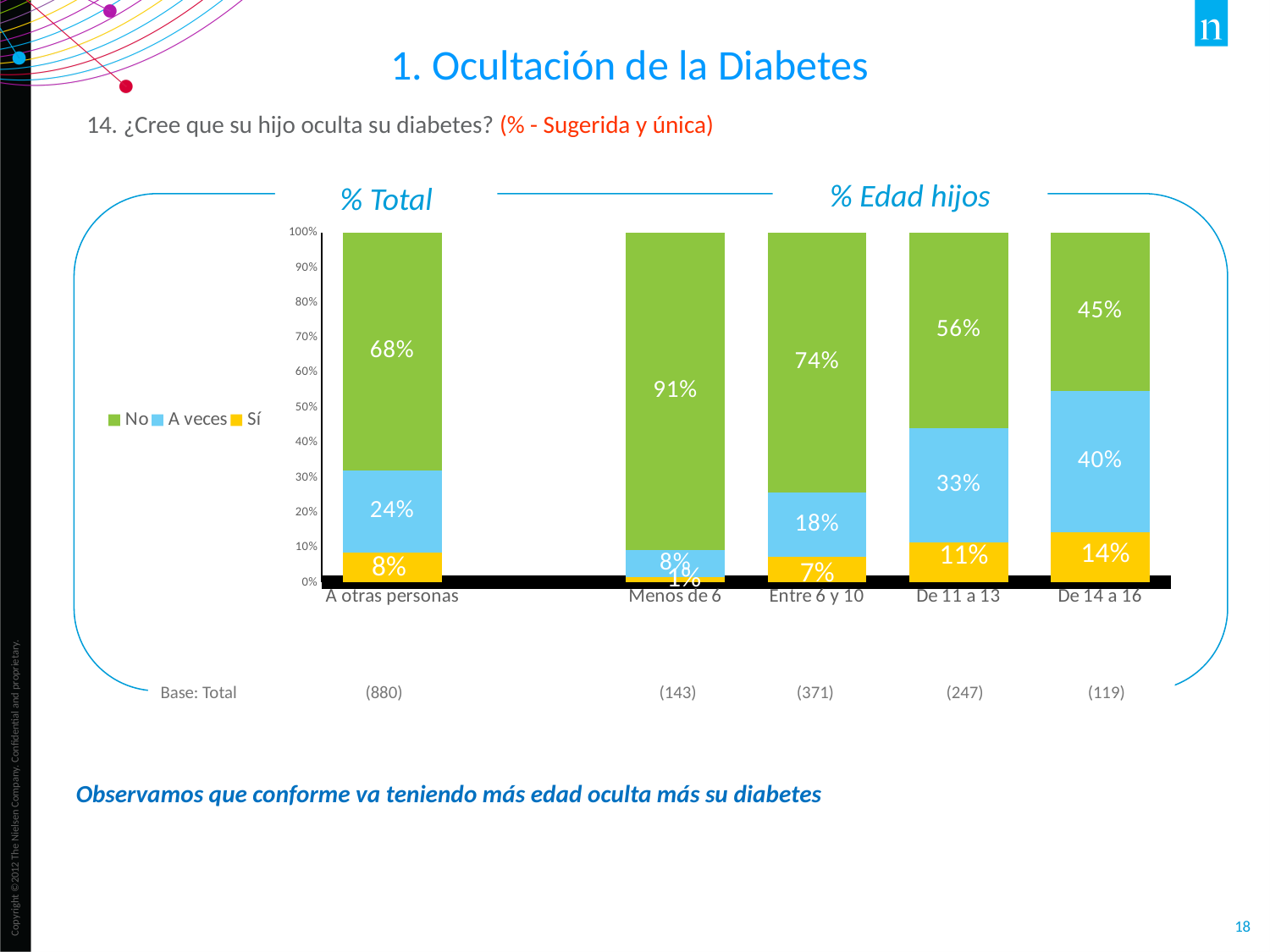
Across the age groups from "Menos de 6" to "De 14 a 16", does the "Sí" value rise or fall? Rise Which is larger: the "A veces" value for "Entre 6 y 10" or for "De 14 a 16"? De 14 a 16 How many categories are shown on the x axis of the chart? 5 What is the "A veces" value for the "De 11 a 13" age group? 33% What is the "Sí" value for the "De 14 a 16" age group? 14% Which category has the lowest "Sí" value? Menos de 6 What is the difference between the "No" values for "Menos de 6" and "De 14 a 16"? 46 percentage points Which age group has the highest "No" value? Menos de 6 Which series is shown in green in the chart? No What percentage of parents answered "No" for the "A otras personas" category? 68% How many series does the legend list? 3 What kind of chart is shown on the slide? Stacked bar chart